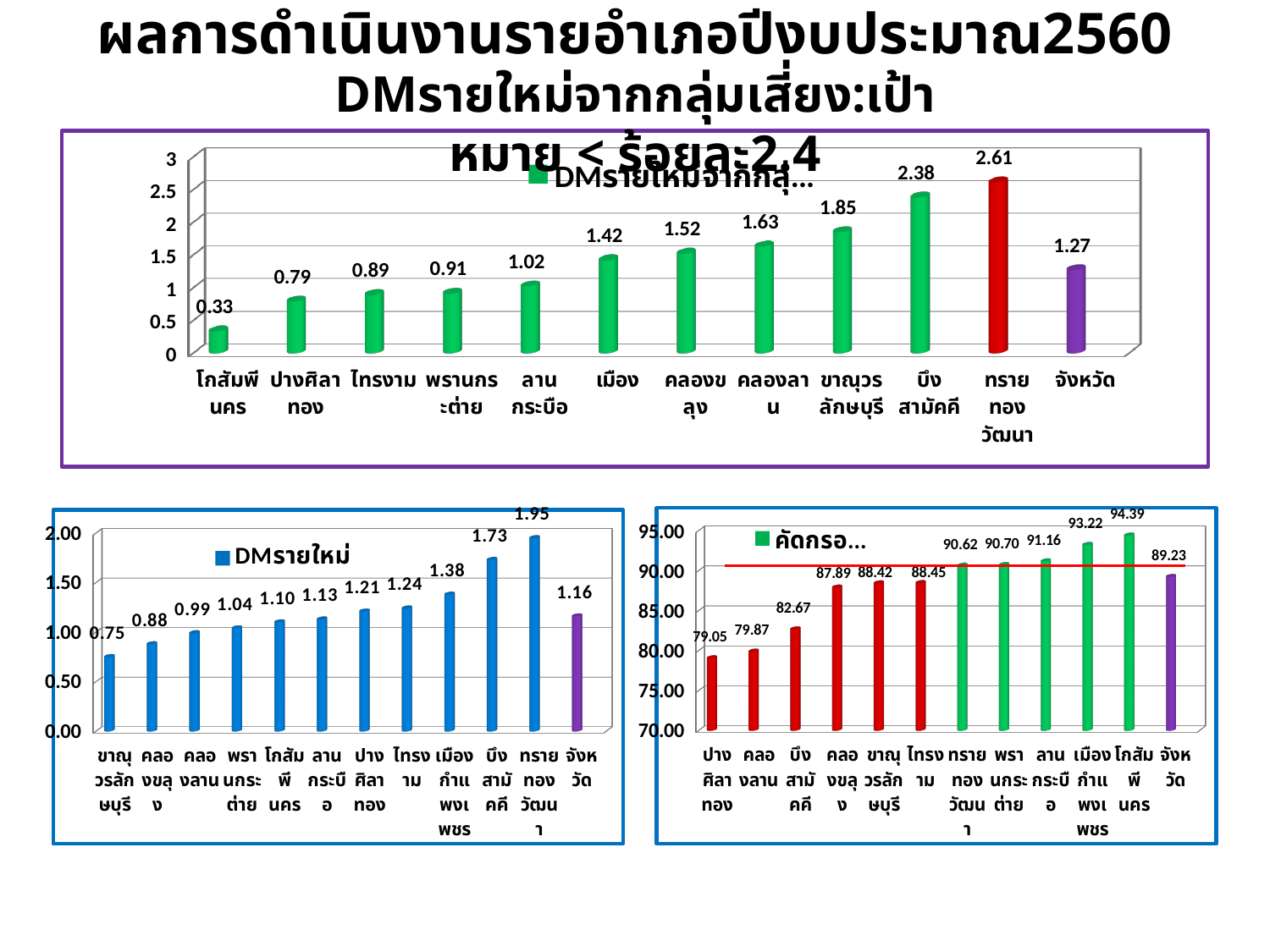
What kind of chart is the bottom-right chart? bar chart In the bottom-left chart, which is larger, the value for คลองลาน or the value for ปางศิลาทอง? ปางศิลาทอง In the top chart, which category has the lowest value? โกสัมพีนคร In the bottom-right chart, what is the value for โกสัมพีนคร? 94.39 In the top chart, what is the difference between the values for บึงสามัคคี and จังหวัด? 1.11 In the bottom-left chart, which category has the highest value? ทรายทองวัฒนา In the bottom-left chart, what is the difference between the values for ทรายทองวัฒนา and ขาณุวรลักษบุรี? 1.20 In the bottom-right chart, is the value for บึงสามัคคี greater or less than 85.00? less In the top chart, how many bars are plotted? 12 In the bottom-left chart, what is the value for เมืองกำแพงเพชร? 1.38 In the top chart, what is the value for ทรายทองวัฒนา? 2.61 In the bottom-right chart, which category has the lowest value? ปางศิลาทอง